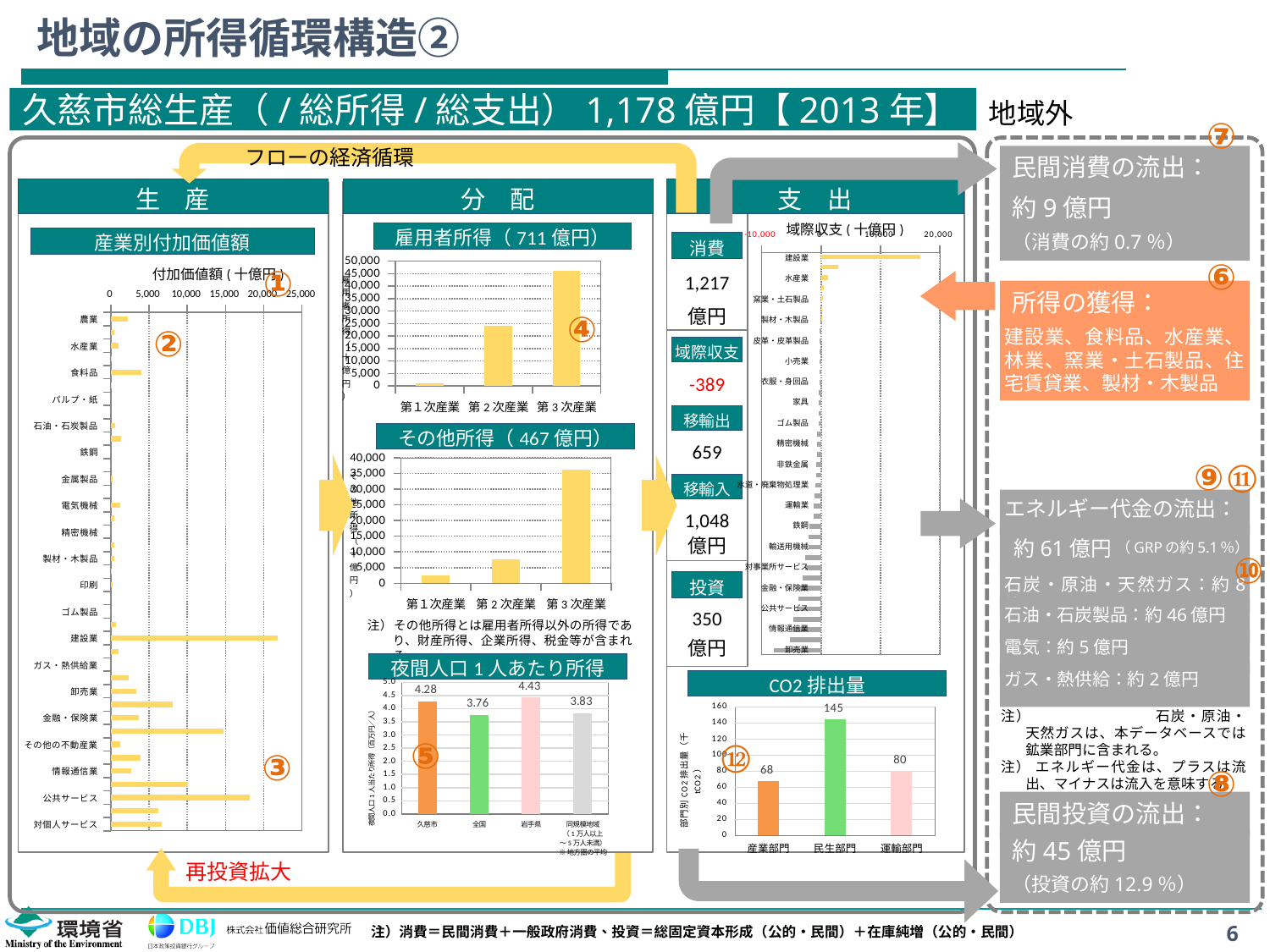
In the CO2排出量 chart, which sector has the highest emissions? 民生部門 In the CO2排出量 chart, which sector has the lowest emissions? 産業部門 In the 夜間人口1人あたり所得 chart, which category has the lowest value? 全国 In the 雇用者所得 chart, which industry category has the highest value? 第3次産業 In the CO2排出量 chart, what is the value for 民生部門? 145 In the CO2排出量 chart, how many sectors are plotted? 3 What kind of chart is the 産業別付加価値額 chart? bar chart In the 夜間人口1人あたり所得 chart, which is larger, 久慈市 or 全国? 久慈市 In the 雇用者所得 chart, is the value for 第2次産業 greater or less than 30,000? less In the CO2排出量 chart, what is the difference between 民生部門 and 産業部門? 77 In the 夜間人口1人あたり所得 chart, what is the value for 久慈市? 4.28 In the 夜間人口1人あたり所得 chart, which category has the highest value? 岩手県